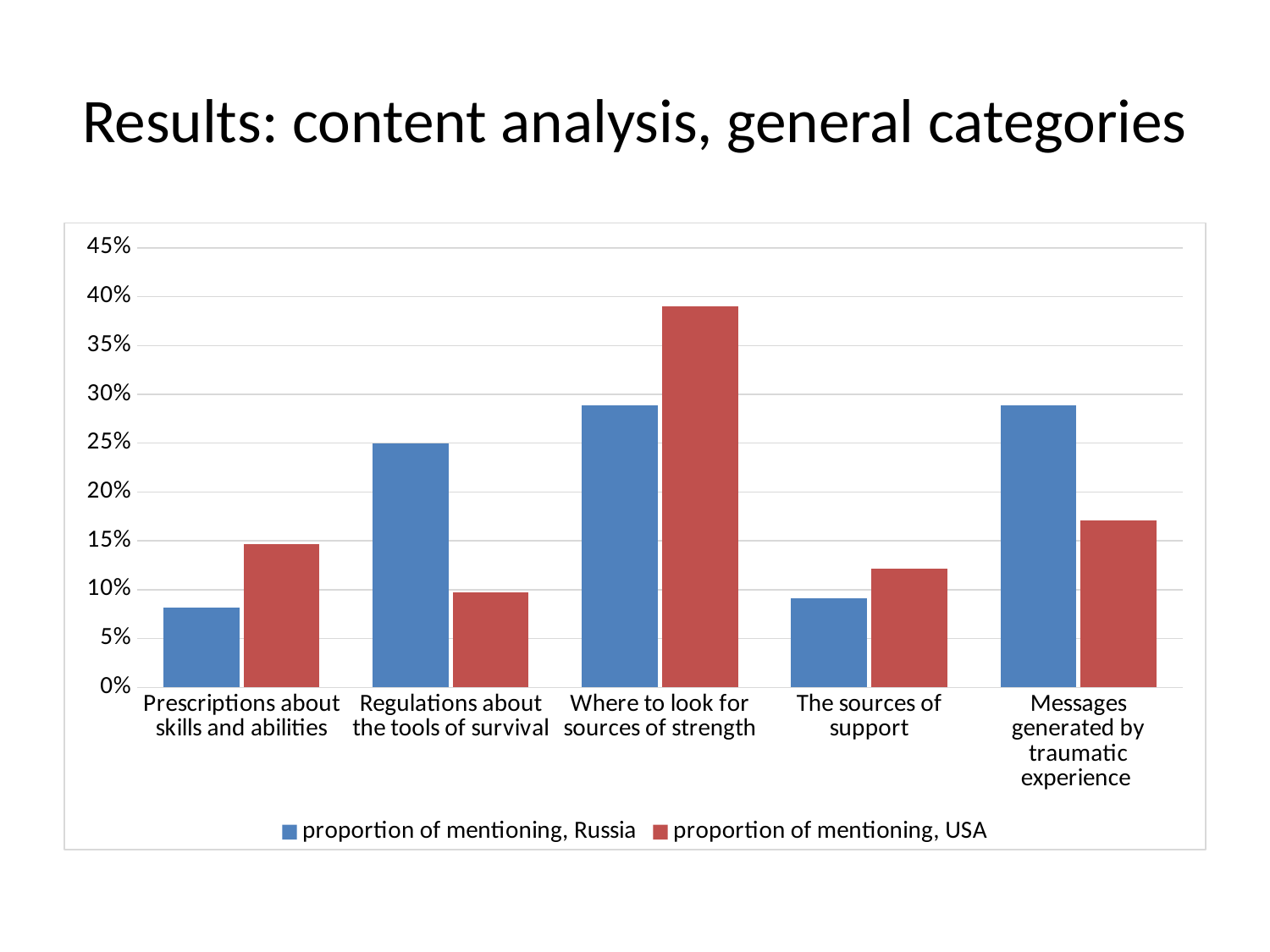
How many series does the legend list? 2 Is the value for 'proportion of mentioning, USA' in 'Where to look for sources of strength' greater or less than 35%? greater Which colour represents 'proportion of mentioning, USA' in the chart? red For 'Regulations about the tools of survival', which series is larger: Russia or USA? Russia Is the value for 'proportion of mentioning, USA' in 'Messages generated by traumatic experience' greater or less than 15%? greater For 'Prescriptions about skills and abilities', which series is larger: Russia or USA? USA For 'Messages generated by traumatic experience', which series is larger: Russia or USA? Russia Which category has the lowest value for 'proportion of mentioning, USA'? Regulations about the tools of survival How many categories are shown on the x axis of the chart? 5 What kind of chart is shown on the slide? bar chart Is the value for 'proportion of mentioning, Russia' in 'Prescriptions about skills and abilities' greater or less than 10%? less Which category has the highest value for 'proportion of mentioning, USA'? Where to look for sources of strength